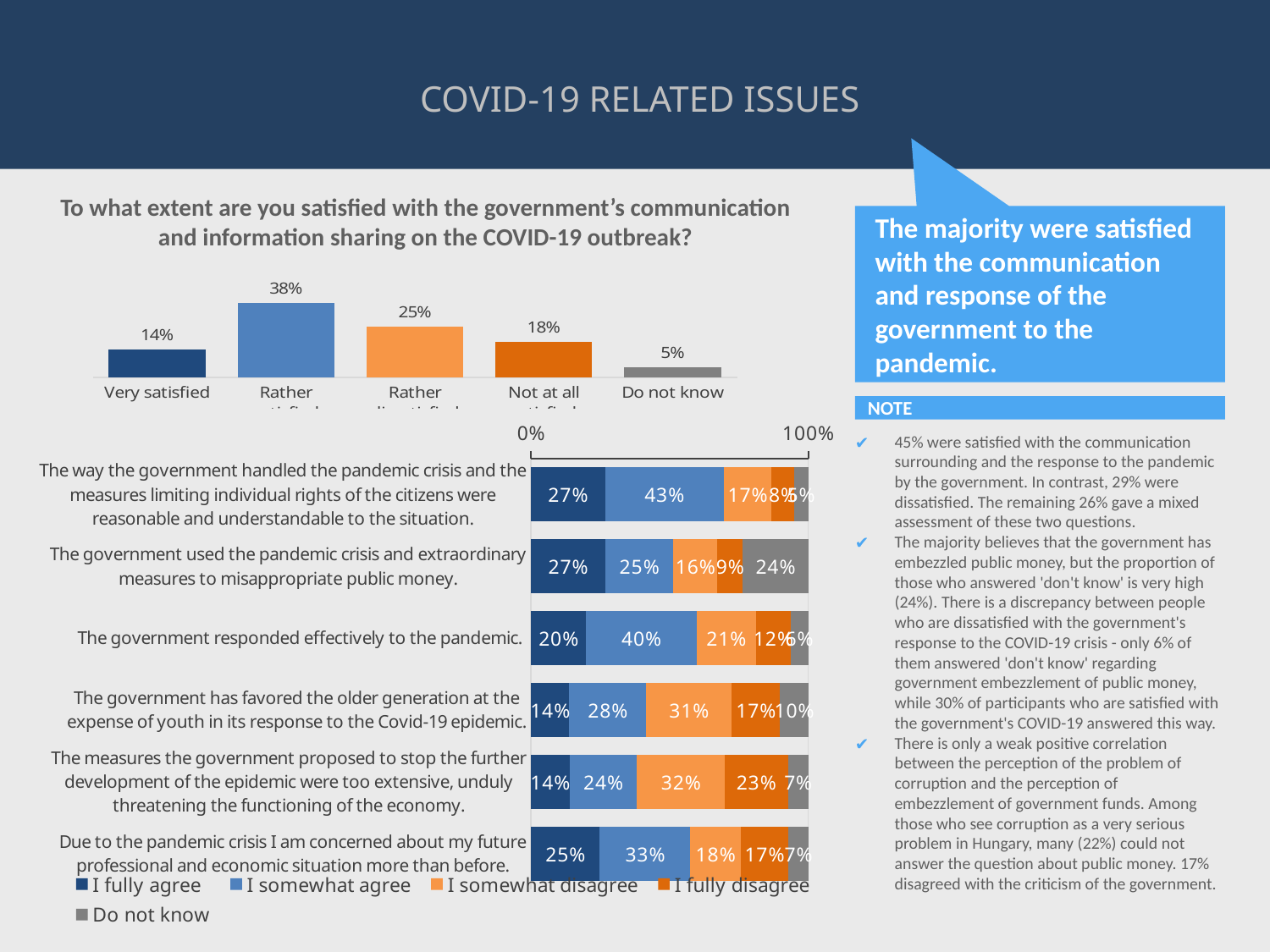
In the top chart about satisfaction with the government's communication, which category has the lowest value? Do not know How many series does the legend of the bottom stacked bar chart list? 5 In the bottom stacked bar chart, what percentage 'fully agree' that the government used the pandemic crisis to misappropriate public money? 27% In the bottom stacked bar chart, what percentage answered 'Do not know' for the statement that the government used the pandemic crisis to misappropriate public money? 24% In the top chart about satisfaction with the government's communication, which category has the highest value? Rather satisfied In the top chart about satisfaction with the government's communication, what is the difference between 'Rather satisfied' and 'Not at all satisfied'? 20% In the bottom stacked bar chart, what percentage 'somewhat agree' that the government responded effectively to the pandemic? 40% In the top chart about satisfaction with the government's communication, how many categories are shown? 5 What type of chart is the top chart about satisfaction with the government's communication? Bar chart In the bottom stacked bar chart, which is larger: the 'I fully agree' share for the statement about being concerned about one's future professional and economic situation, or the 'I fully agree' share for the statement that the measures were too extensive? Concerned about future professional and economic situation In the bottom stacked bar chart, what percentage 'somewhat disagree' that the government has favored the older generation at the expense of youth? 31% In the top chart about satisfaction with the government's communication, what percentage were 'Very satisfied'? 14%